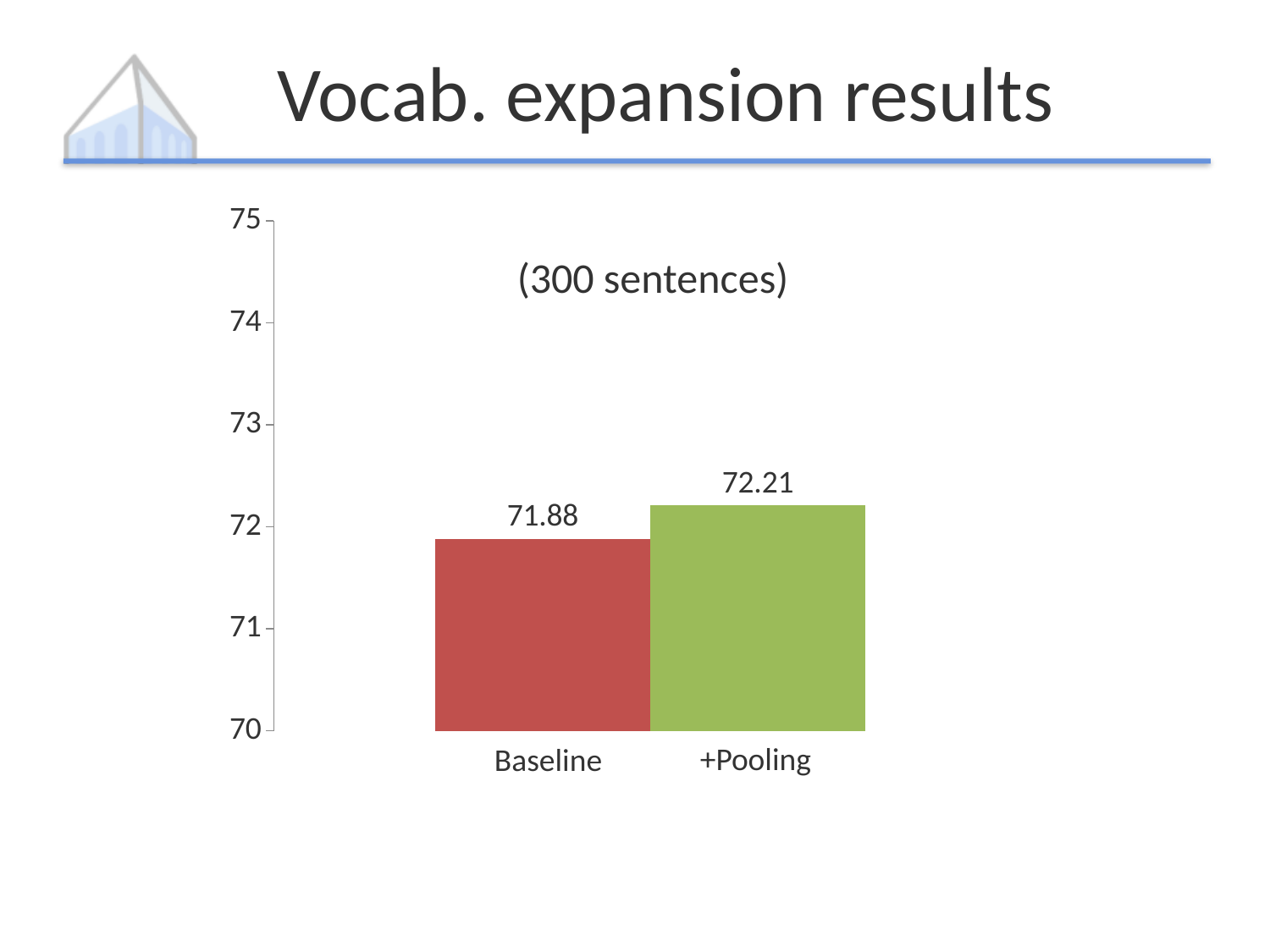
Which category has the highest value? +Pooling What colour is the +Pooling bar? green What is the value for Baseline? 71.88 What is the value for +Pooling? 72.21 What kind of chart is shown on the slide? bar chart How many categories are shown in the chart? 2 What text appears inside the chart area above the bars? (300 sentences) Is the value for Baseline greater or less than 72? less Is the value for +Pooling greater or less than 72? greater Which is larger, the value for Baseline or the value for +Pooling? +Pooling What is the difference between the +Pooling and Baseline values? 0.33 Which category has the lowest value? Baseline